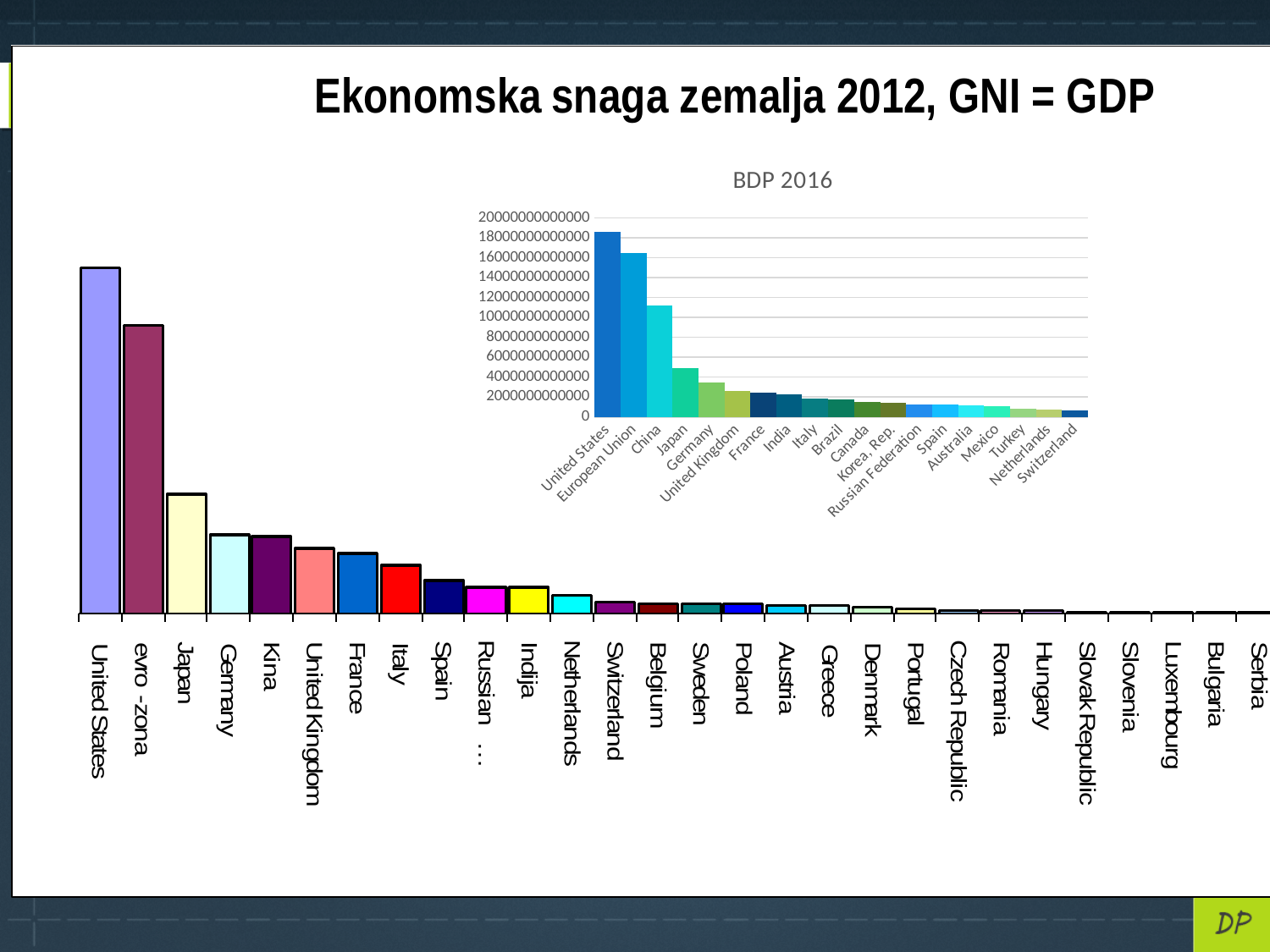
How many countries are shown in the BDP 2016 chart? 19 In the BDP 2016 chart, is the value for Switzerland greater or less than 2000000000000? less In the BDP 2016 chart, is the value for Germany greater or less than 4000000000000? less In the BDP 2016 chart, do the values rise or fall from left to right along the x axis? fall In the BDP 2016 chart, which is larger, the value for China or the value for Japan? China In the BDP 2016 chart, is the value for China greater or less than 10000000000000? greater In the large chart on the left, which is larger, the bar for Japan or the bar for Germany? Japan In the large chart on the left, which category has the highest bar? United States What kind of chart is the large chart on the left of the slide? bar chart In the BDP 2016 chart, which country has the highest value? United States In the BDP 2016 chart, which country has the lowest value? Switzerland